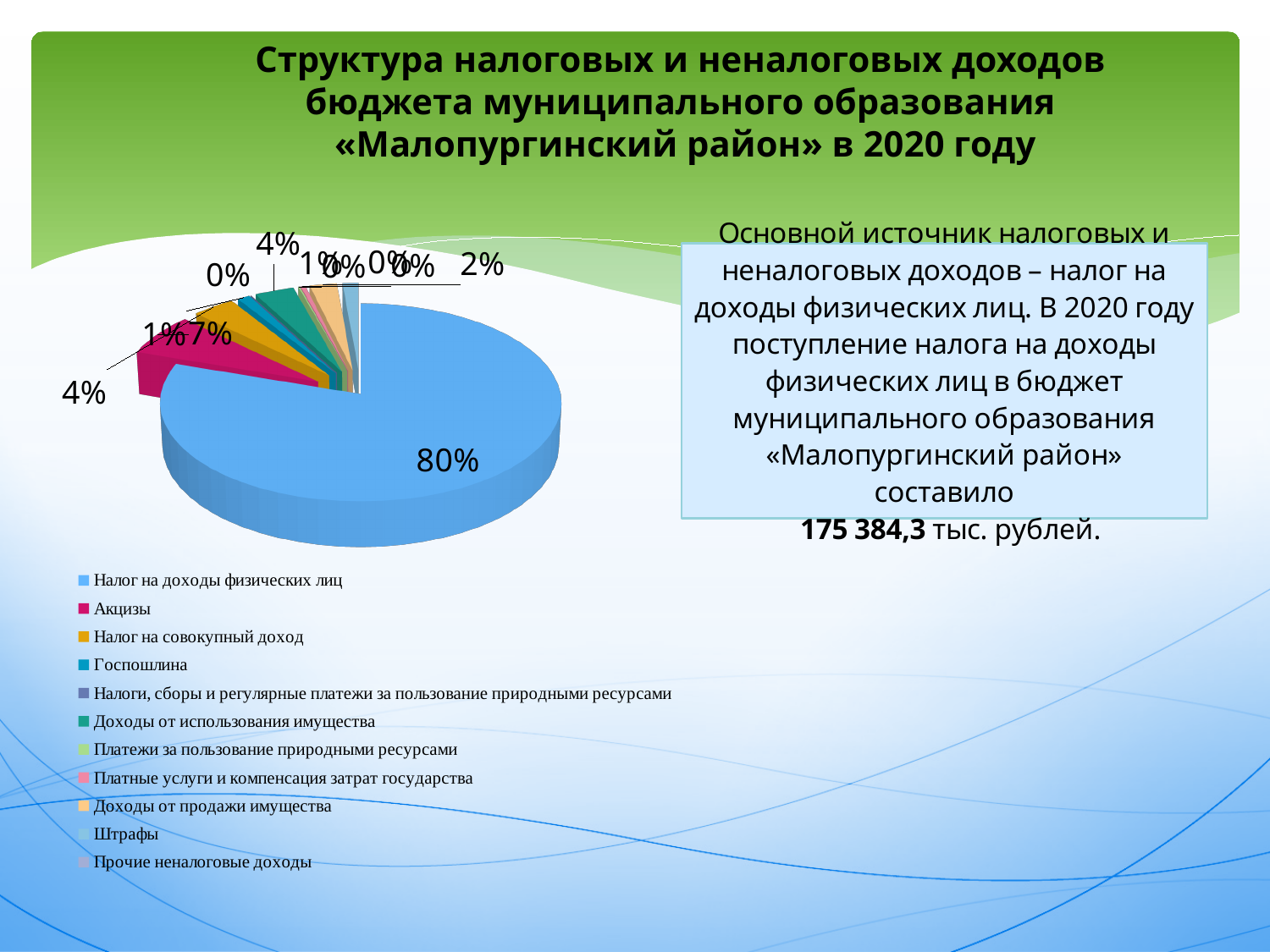
Is the share for Налог на доходы физических лиц greater or less than 50%? greater Which category is listed first in the legend of the pie chart? Налог на доходы физических лиц Which category is listed last in the legend of the pie chart? Прочие неналоговые доходы What colour is the largest slice of the pie chart? blue What kind of chart is shown on the slide? pie chart What share of the pie does Налог на доходы физических лиц account for? 80% Which category has the largest slice of the pie? Налог на доходы физических лиц Which is larger: the slice for Налог на доходы физических лиц or the slice for Акцизы? Налог на доходы физических лиц How many categories does the legend of the pie chart list? 11